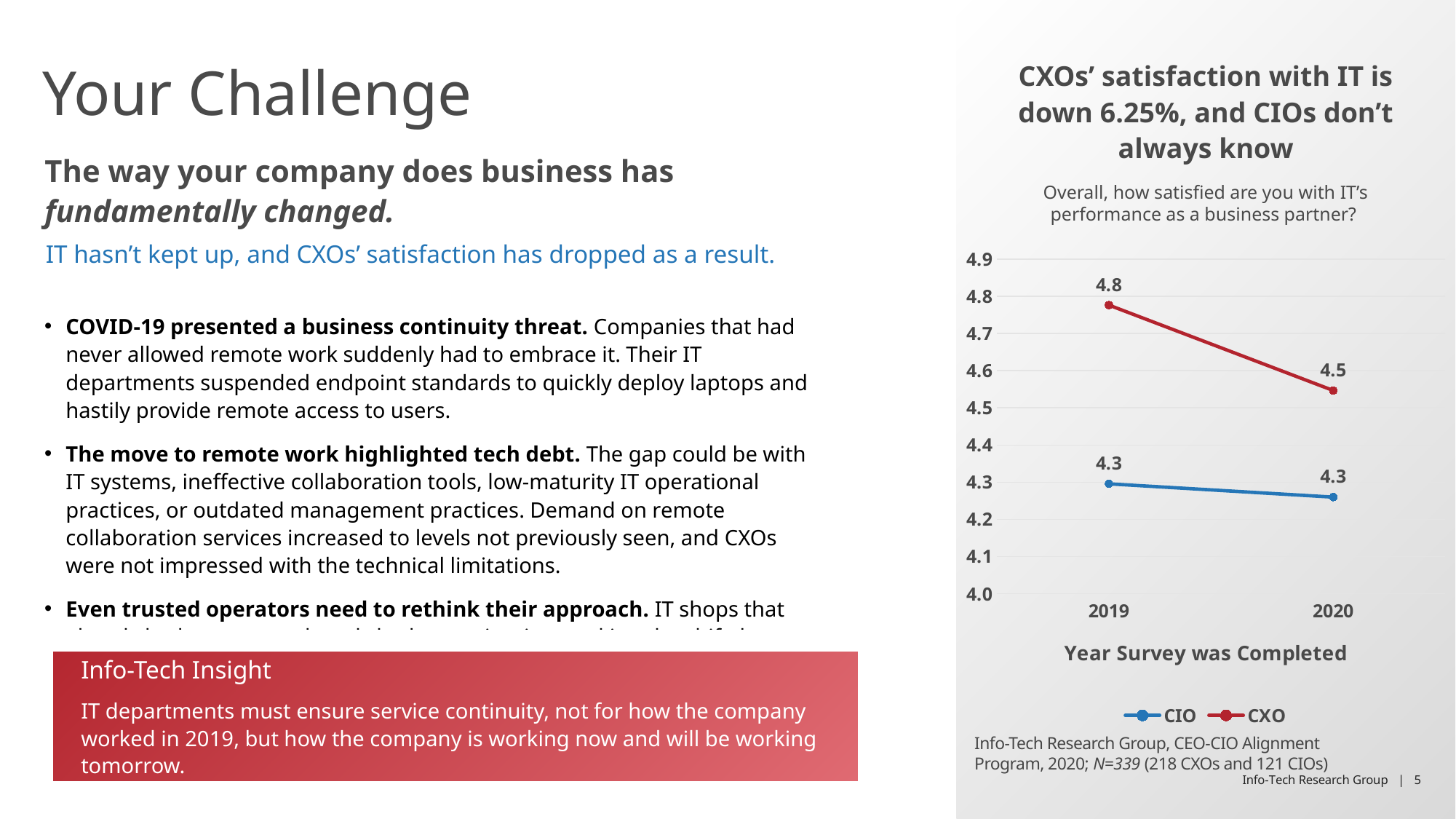
In 2019, which series has the higher value, CIO or CXO? CXO How many series does the legend list? 2 What was the CIO satisfaction value in 2019? 4.3 Does the CXO line rise or fall from 2019 to 2020? fall What is the title of the x axis of the chart? Year Survey was Completed What was the CIO satisfaction value in 2020? 4.3 What is the difference between the CXO and CIO values in 2020? 0.2 What kind of chart is shown on the slide? line chart How many years are plotted on the x axis? 2 What was the CXO satisfaction value in 2019? 4.8 By how much did the CXO value drop from 2019 to 2020? 0.3 What was the CXO satisfaction value in 2020? 4.5